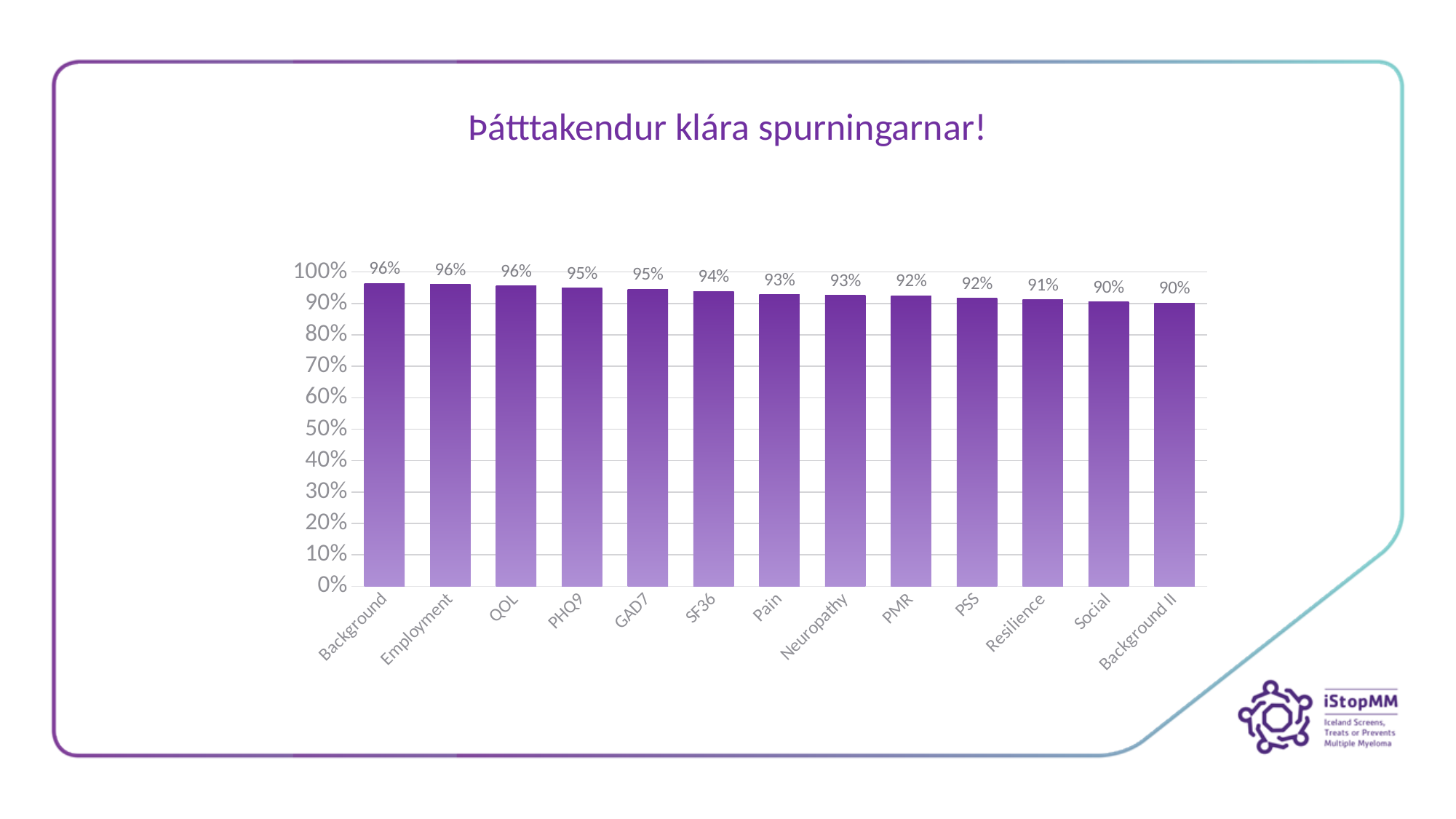
What is the difference between the values for Background and Background II? 6% What is the value for SF36? 94% What kind of chart is shown on the slide? Bar chart What is the value for QOL? 96% What is the title of the chart? Þátttakendur klára spurningarnar! What is the value for Resilience? 91% What is the value for Background II? 90% Do the values rise or fall from left to right along the x axis? Fall What is the difference between the values for PHQ9 and PMR? 3% How many categories are shown on the x axis? 13 Which is larger, the value for Employment or the value for Social? Employment What is the value for Neuropathy? 93%